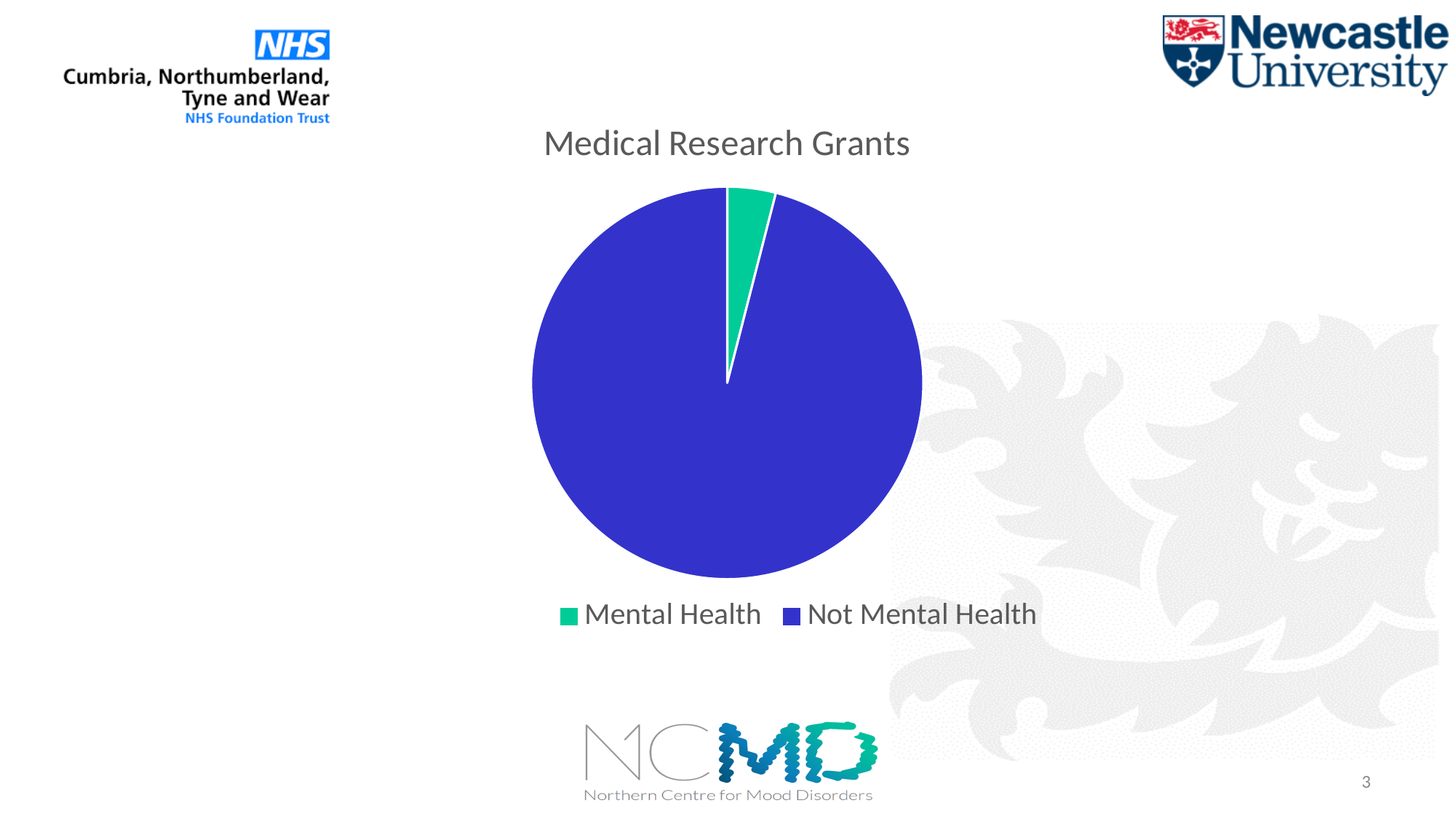
What is the title of the chart? Medical Research Grants Which is larger, the Mental Health slice or the Not Mental Health slice? Not Mental Health How many entries does the legend list? 2 How many slices does the pie chart have? 2 Which slice of the pie is the smallest? Mental Health What colour is the Mental Health slice? green Which slice of the pie is the largest? Not Mental Health What kind of chart is shown on the slide? pie chart